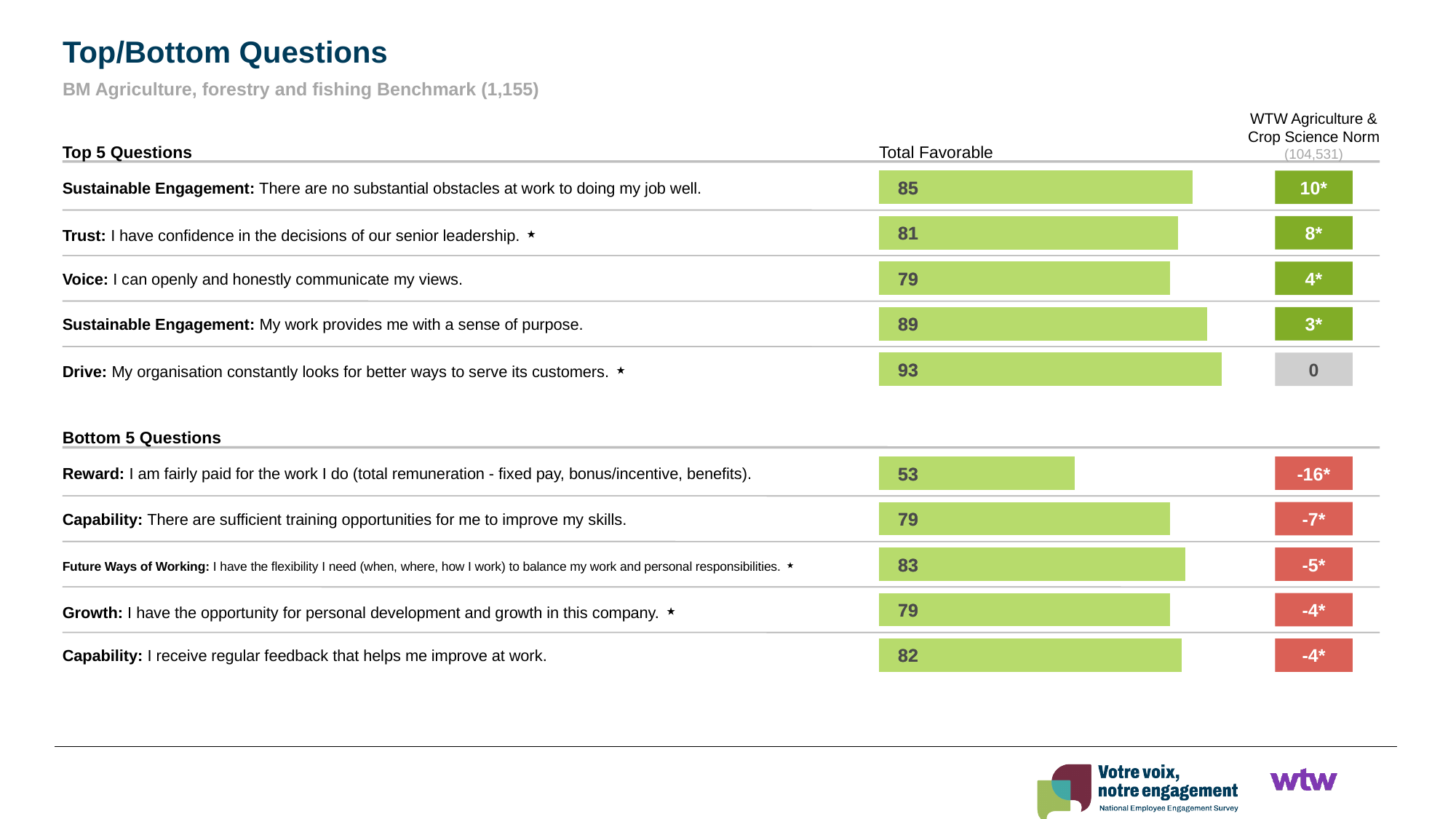
In the Top 5 Questions chart, which question has the highest Total Favorable value? Drive: My organisation constantly looks for better ways to serve its customers. In the Bottom 5 Questions chart, what is the difference in Total Favorable between the Future Ways of Working question (83) and the Reward question (53)? 30 How many questions are shown in the Bottom 5 Questions chart? 5 In the Bottom 5 Questions chart, what is the Total Favorable value for "Reward: I am fairly paid for the work I do"? 53 In the Top 5 Questions chart, which has a higher Total Favorable: "Sustainable Engagement: My work provides me with a sense of purpose" or "Voice: I can openly and honestly communicate my views"? Sustainable Engagement: My work provides me with a sense of purpose. In the Top 5 Questions chart, what is the difference in Total Favorable between the Drive question (93) and the Voice question (79)? 14 In the Bottom 5 Questions chart, what is the WTW Agriculture & Crop Science Norm difference shown for the Reward question? -16* What kind of chart is used to show the Total Favorable values on this slide? Bar chart In the Bottom 5 Questions chart, which question has the lowest Total Favorable value? Reward: I am fairly paid for the work I do (total remuneration - fixed pay, bonus/incentive, benefits). In the Top 5 Questions chart, what is the Total Favorable value for "Trust: I have confidence in the decisions of our senior leadership"? 81 In the Top 5 Questions chart, what is the Total Favorable value for "Drive: My organisation constantly looks for better ways to serve its customers"? 93 In the Top 5 Questions chart, what is the WTW Agriculture & Crop Science Norm difference shown for "Sustainable Engagement: There are no substantial obstacles at work to doing my job well"? 10*